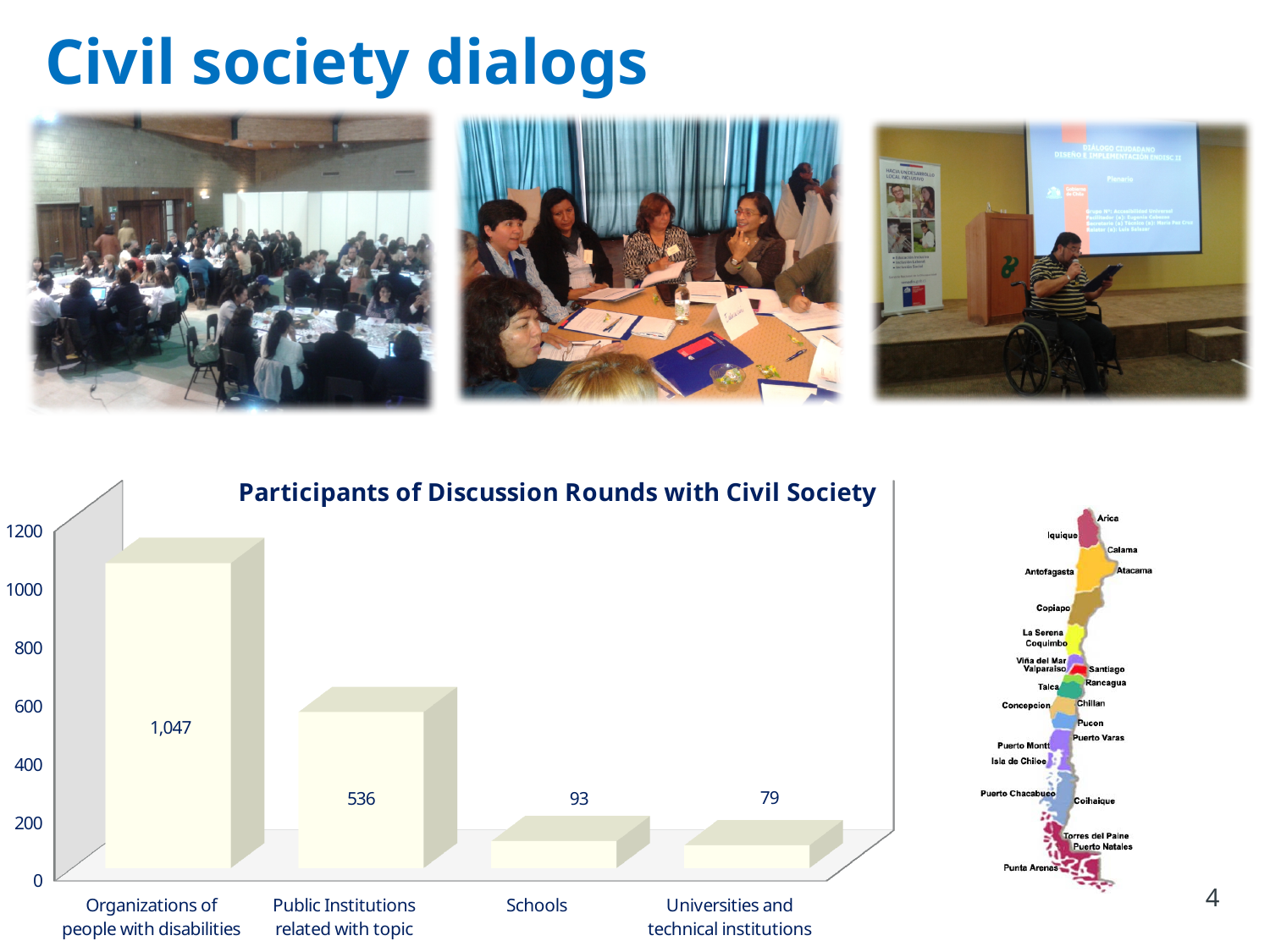
What is the title of the chart on the slide? Participants of Discussion Rounds with Civil Society Do the values rise or fall from left to right across the categories? fall What is the difference in participants between organizations of people with disabilities and public institutions related with topic? 511 How many participants came from universities and technical institutions? 79 How many participants came from organizations of people with disabilities? 1,047 Which category has the lowest number of participants? Universities and technical institutions How many participants came from schools? 93 Which has more participants, schools or universities and technical institutions? Schools How many categories are shown in the chart? 4 What kind of chart is shown on the slide? bar chart How many participants came from public institutions related with topic? 536 Which category has the highest number of participants? Organizations of people with disabilities